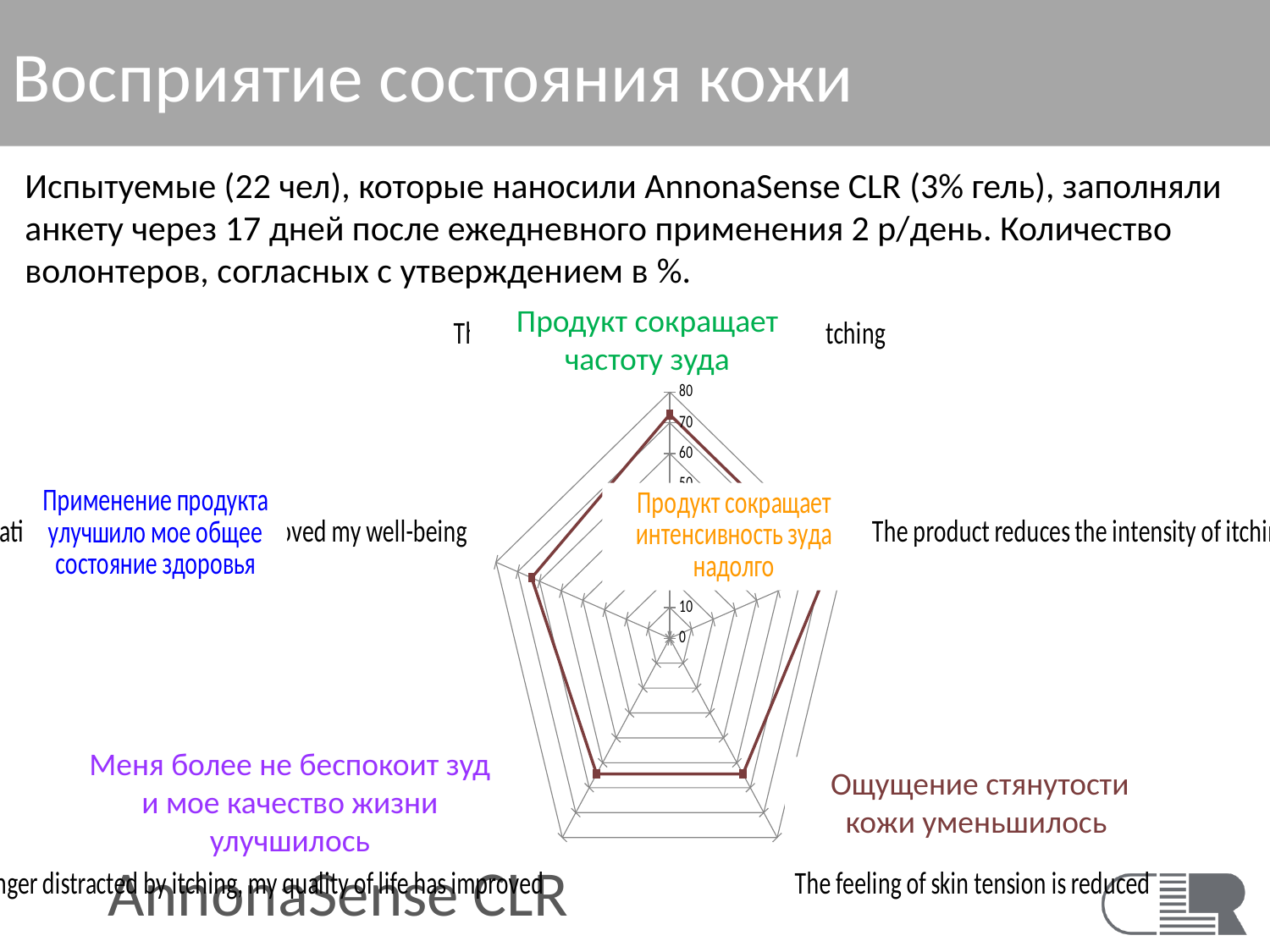
How many axes (categories) does the radar chart have? 5 Which is larger: the value for 'Продукт сокращает частоту зуда' or the value for 'Ощущение стянутости кожи уменьшилось'? Продукт сокращает частоту зуда Is the value for 'Продукт сокращает частоту зуда' greater or less than 60? greater Is the value for 'Ощущение стянутости кожи уменьшилось' greater or less than 80? less What kind of chart is shown on the slide? radar chart What is the highest tick value shown on the radar chart's axis scale? 80 Is the value for 'Применение продукта улучшило мое общее состояние здоровья' greater or less than 80? less Which is larger: the value for 'Продукт сокращает частоту зуда' or the value for 'Меня более не беспокоит зуд и мое качество жизни улучшилось'? Продукт сокращает частоту зуда Which statement is labelled at the top axis of the radar chart (in Russian)? Продукт сокращает частоту зуда